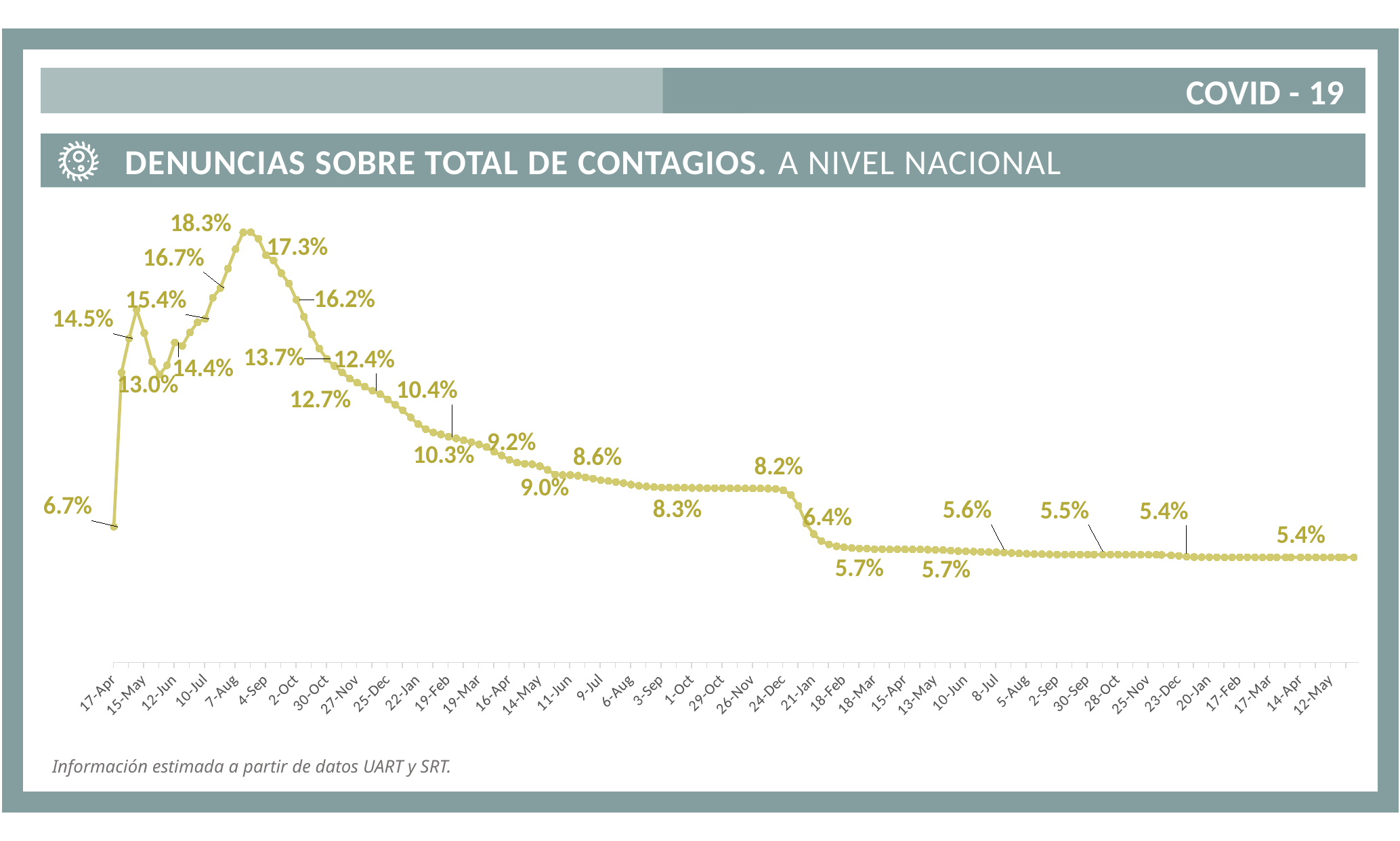
What is the lowest value labelled on the chart? 5.4% What kind of chart is shown on the slide? Line chart What is the value of the first data point on the chart (17-Apr)? 6.7% How many lines (series) are plotted on the chart? 1 What is the difference between the 8.2% label and the 6.4% label that follows it? 1.8 percentage points What is the title of the chart? DENUNCIAS SOBRE TOTAL DE CONTAGIOS. A NIVEL NACIONAL What is the value of the last data point on the chart? 5.4% What is the highest value labelled on the chart? 18.3% After reaching its peak of 18.3%, does the line generally rise or fall toward the end of the chart? Fall Which is larger, the first data point or the last data point on the chart? The first data point (6.7%) According to the note below the chart, what data sources is the information estimated from? UART y SRT What is the difference between the peak value of 18.3% and the first value of 6.7%? 11.6 percentage points